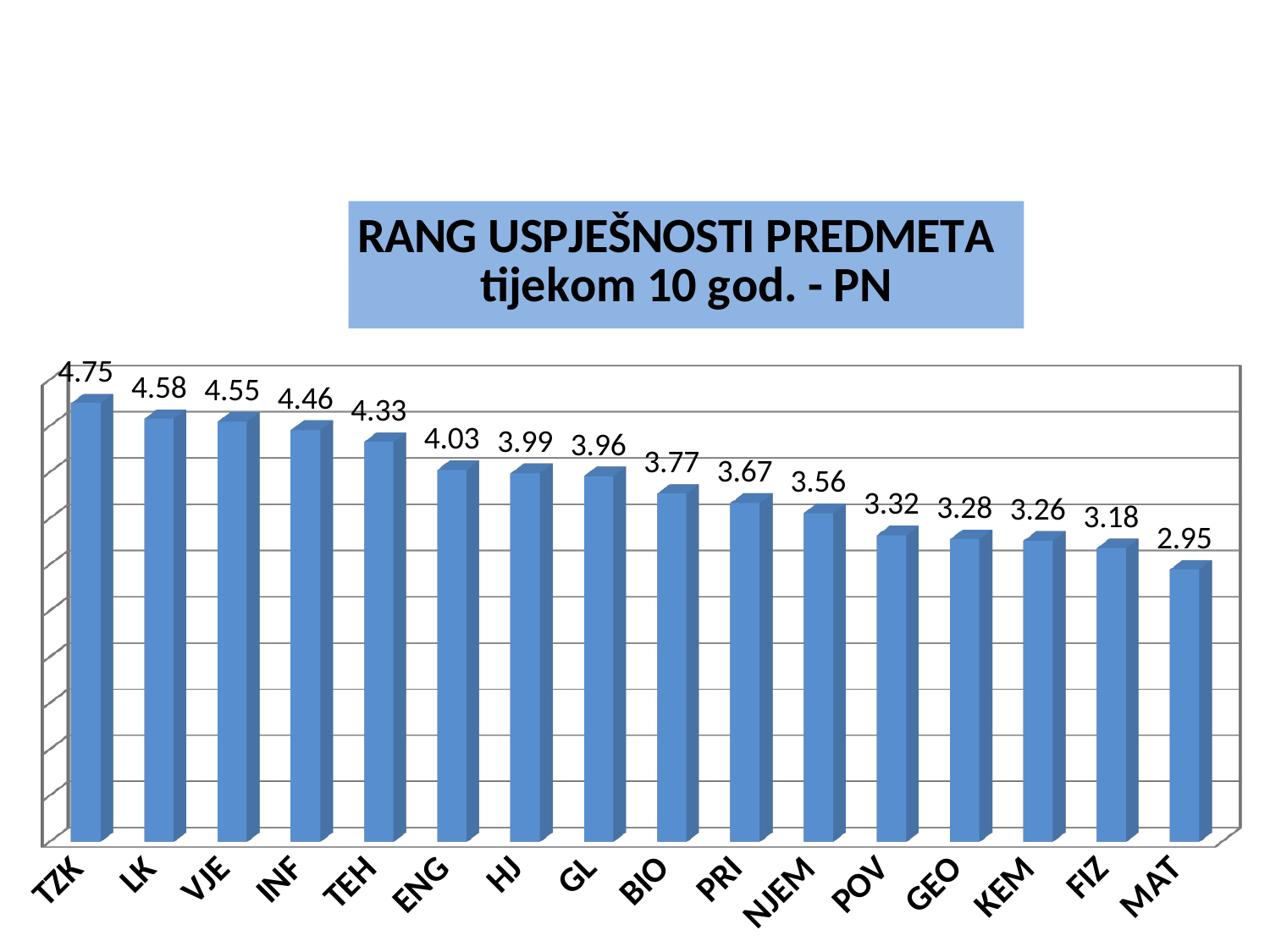
What is the difference between the values for INF and TEH? 0.13 Which is larger, the value for BIO or the value for POV? BIO What is the value for NJEM? 3.56 What is the value for TZK? 4.75 Which category has the lowest value? MAT Do the values rise or fall from left to right along the x axis? fall What is the title of the chart? RANG USPJEŠNOSTI PREDMETA tijekom 10 god. - PN What kind of chart is shown on the slide? bar chart How many categories are shown on the x axis? 16 What is the value for ENG? 4.03 What is the difference between the values for TZK and MAT? 1.80 Which category has the highest value? TZK